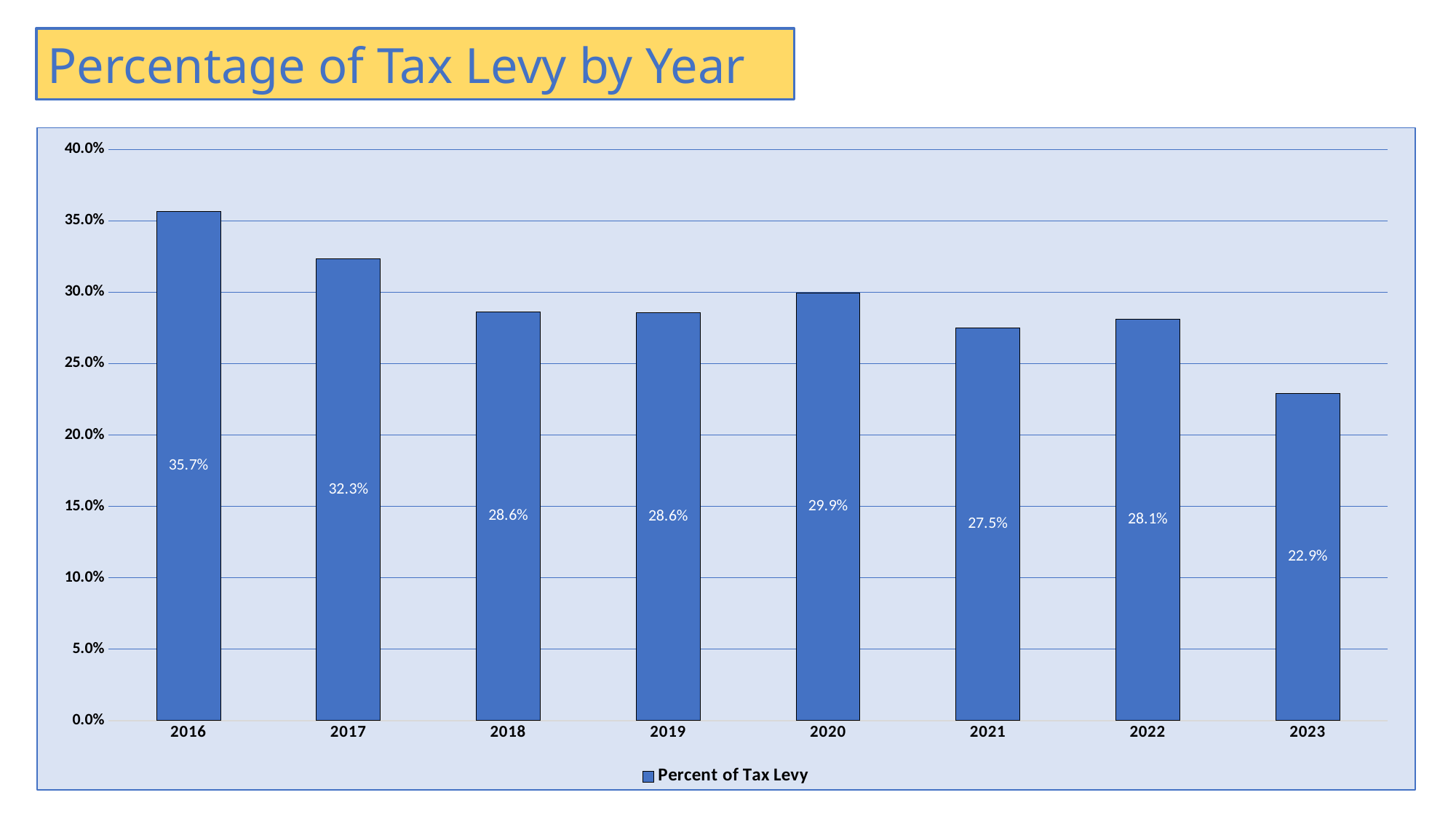
Which year has the highest percent of tax levy? 2016 Which year has a larger percent of tax levy, 2020 or 2021? 2020 What is the difference between the percent of tax levy in 2016 and 2023? 12.8% What kind of chart is shown on the slide? Bar chart What is the percent of tax levy for 2020? 29.9% How many series does the legend list? 1 Which year has the lowest percent of tax levy? 2023 What is the title of the slide? Percentage of Tax Levy by Year What is the percent of tax levy for 2016? 35.7% Is the value for 2017 greater or less than 30.0%? greater What is the percent of tax levy for 2023? 22.9% How many years are shown on the chart? 8